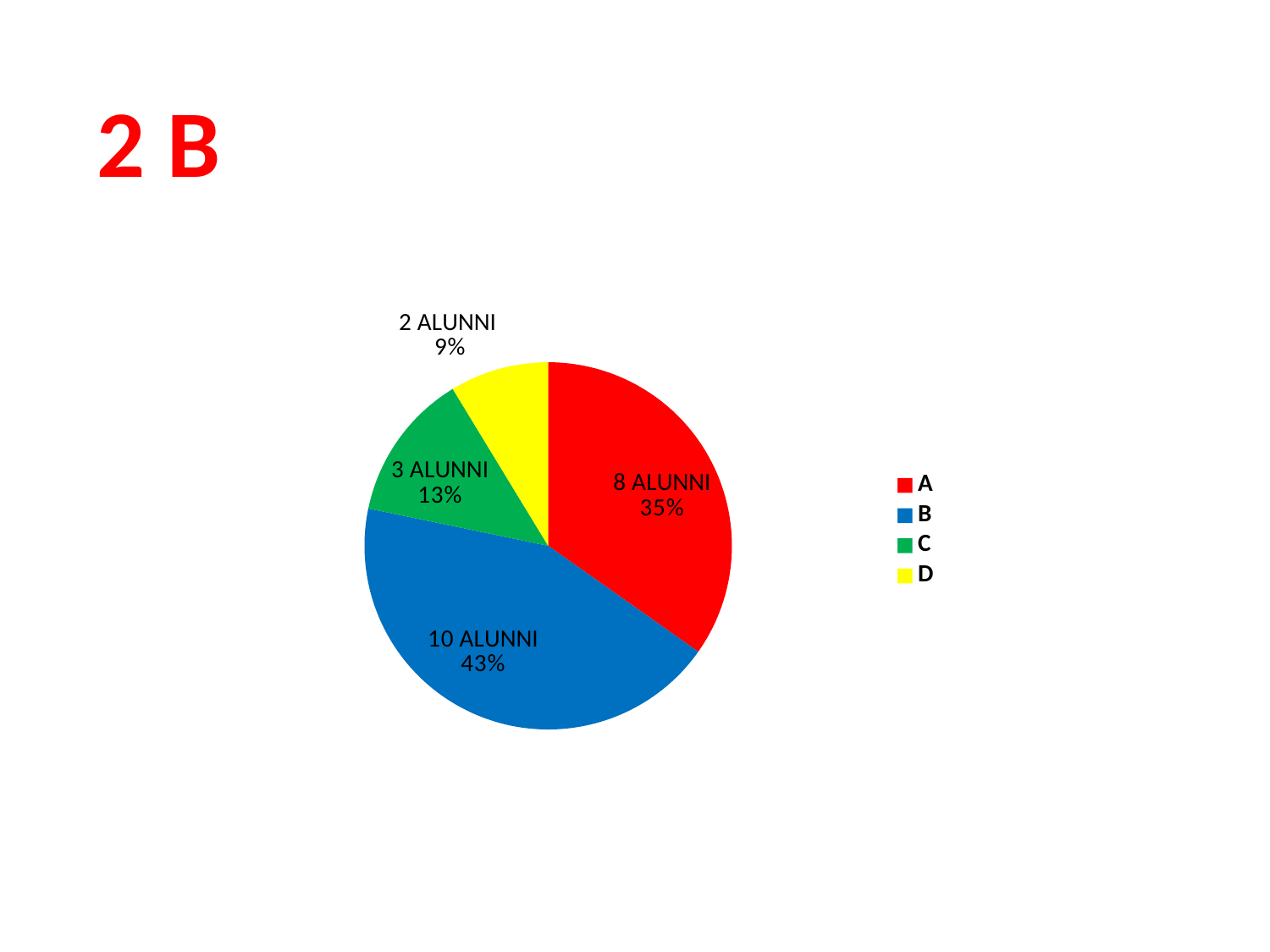
How many alunni are in category C? 3 ALUNNI What kind of chart is shown on the slide? pie chart How many slices does the pie chart have? 4 What percentage share does category B have? 43% Which category has the smallest slice? D What colour is the slice for category C? green What percentage share does category A have? 35% How many alunni are in category D? 2 ALUNNI Which category has the largest slice? B How many entries does the legend list? 4 What is the difference in the number of alunni between category B and category A? 2 Which has more alunni, category A or category C? A